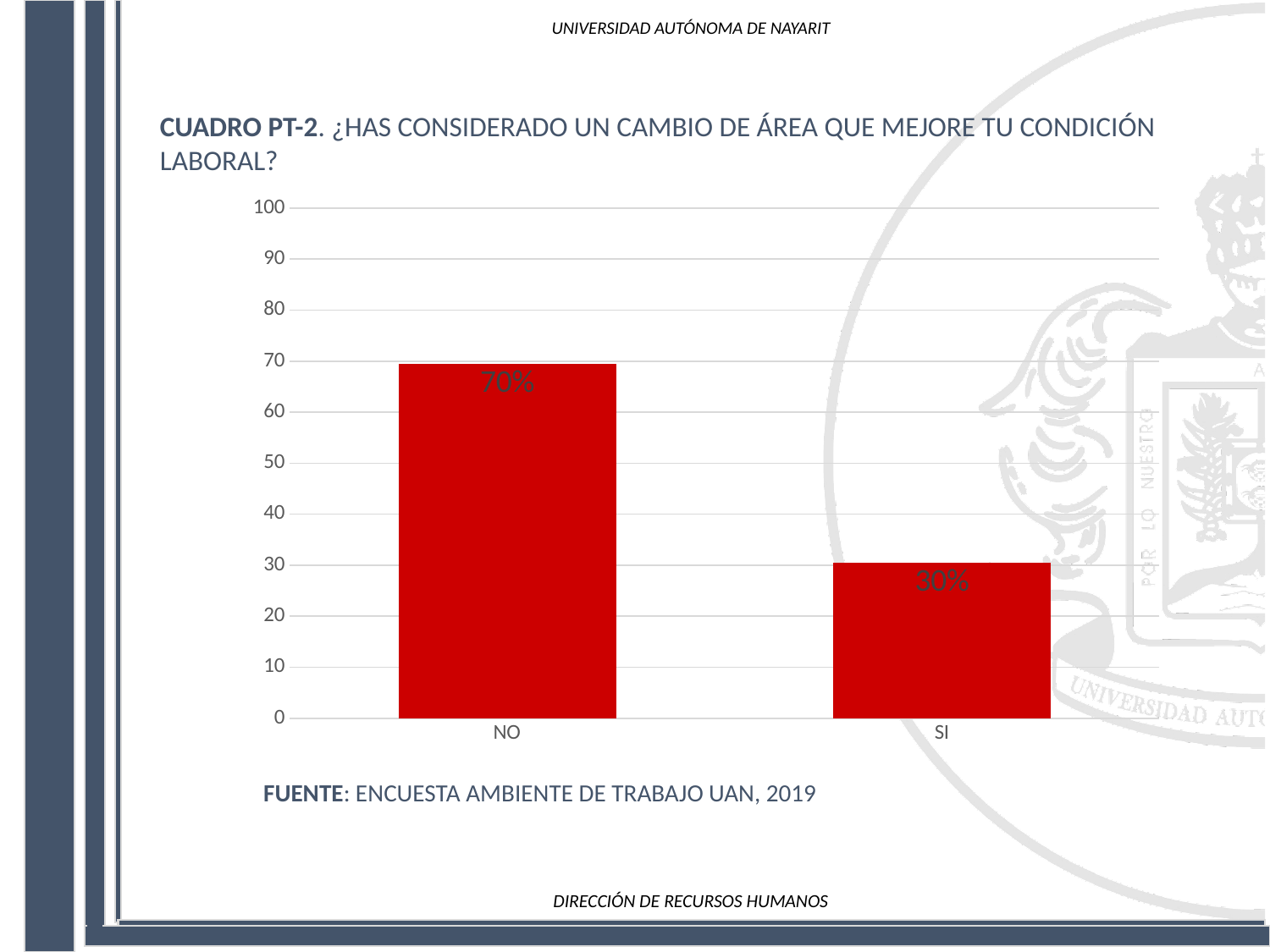
What colour are the bars in the chart? red Which category has the highest value? NO Which category has the lowest value? SI How many categories are shown on the x axis? 2 Which is larger, the value for NO or the value for SI? NO What kind of chart is shown on the slide? bar chart Is the value for SI greater or less than 40? less What is the value for NO? 70% What is the difference between the values for NO and SI? 40% What is the source cited below the chart? ENCUESTA AMBIENTE DE TRABAJO UAN, 2019 Is the value for NO greater or less than 50? greater What is the value for SI? 30%